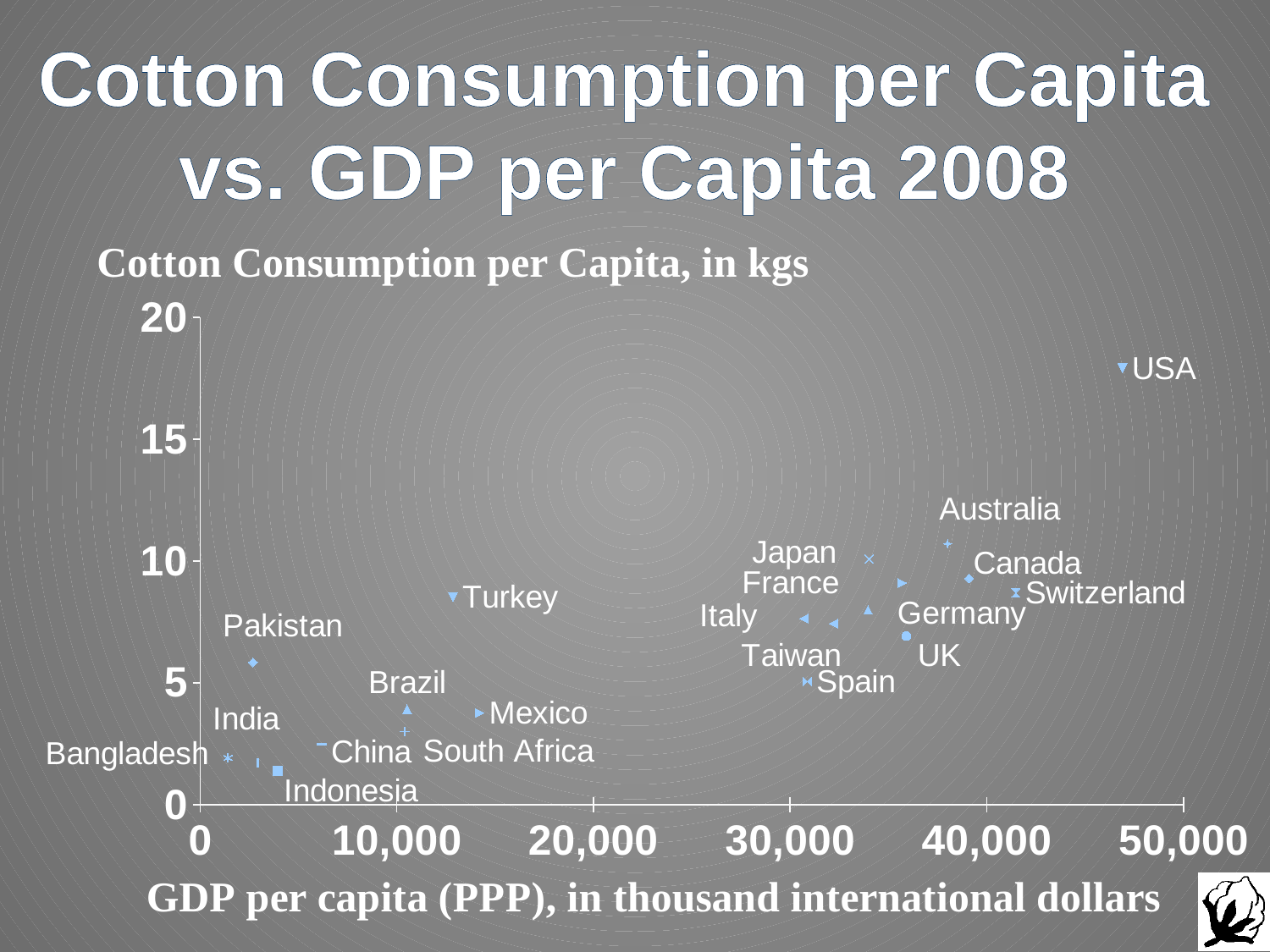
Is the GDP per capita for Japan greater or less than 40,000? less Is the GDP per capita for Pakistan greater or less than 10,000? less Which has higher cotton consumption per capita, Turkey or Pakistan? Turkey Which country has the lowest GDP per capita? Bangladesh Which country has the highest cotton consumption per capita? USA Which country has the highest GDP per capita? USA How many countries are plotted on the chart? 20 Is the cotton consumption per capita for USA greater or less than 15 kgs? greater What kind of chart is shown on the slide? scatter chart Which has higher cotton consumption per capita, USA or Australia? USA What is the label of the vertical axis? Cotton Consumption per Capita, in kgs